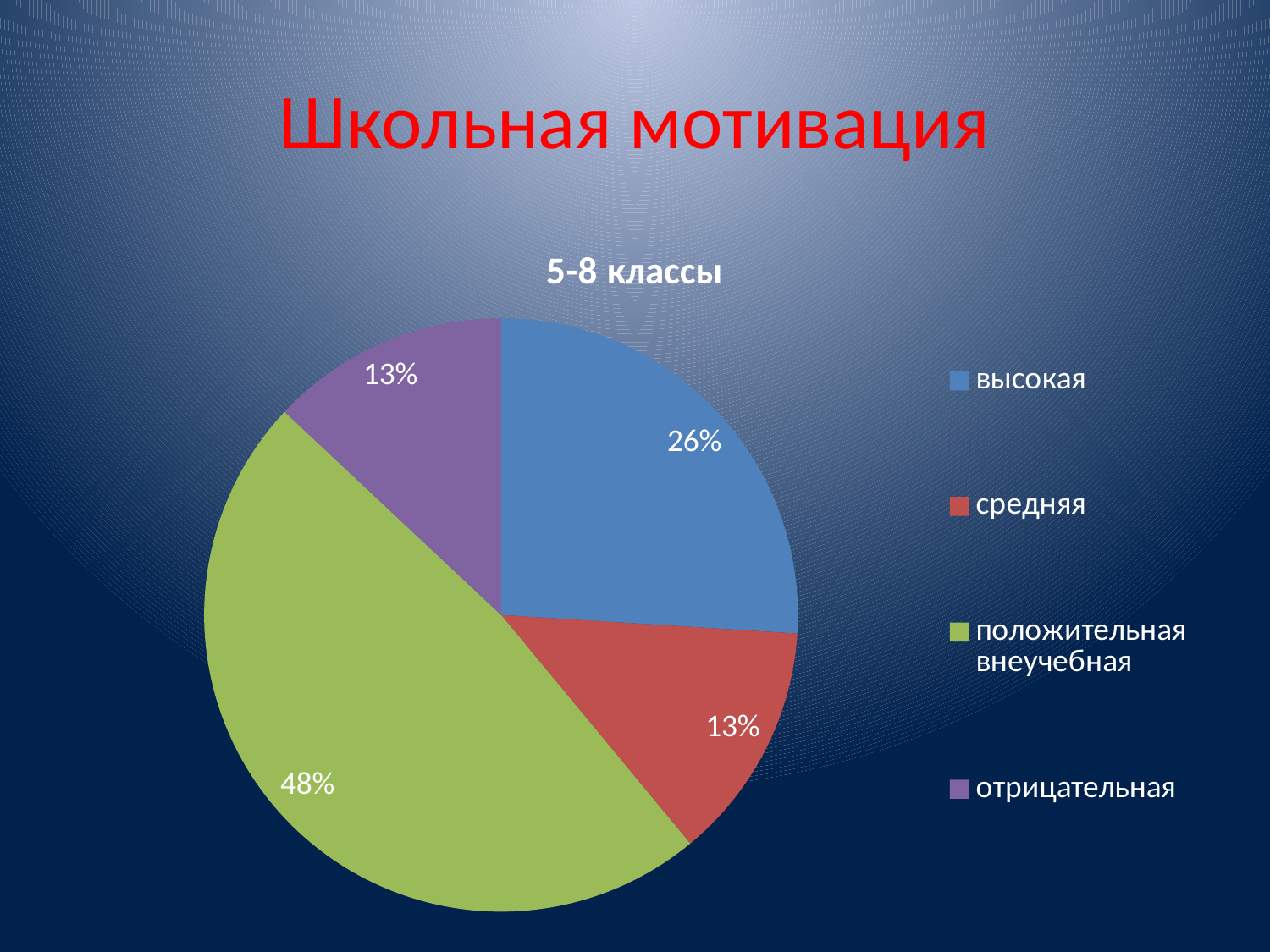
What share of the pie does the 'высокая' slice represent? 26% What share of the pie does the 'средняя' slice represent? 13% What type of chart is shown on the slide? pie chart Which category has the largest share of the pie? положительная внеучебная What is the difference between the 'положительная внеучебная' share and the 'высокая' share? 22% What share of the pie does the 'положительная внеучебная' slice represent? 48% What share of the pie does the 'отрицательная' slice represent? 13% Which is larger, the 'высокая' share or the 'средняя' share? высокая What is the title of the chart? 5-8 классы What colour is the 'положительная внеучебная' slice? green What is the combined share of 'средняя' and 'отрицательная'? 26% How many categories does the legend list? 4